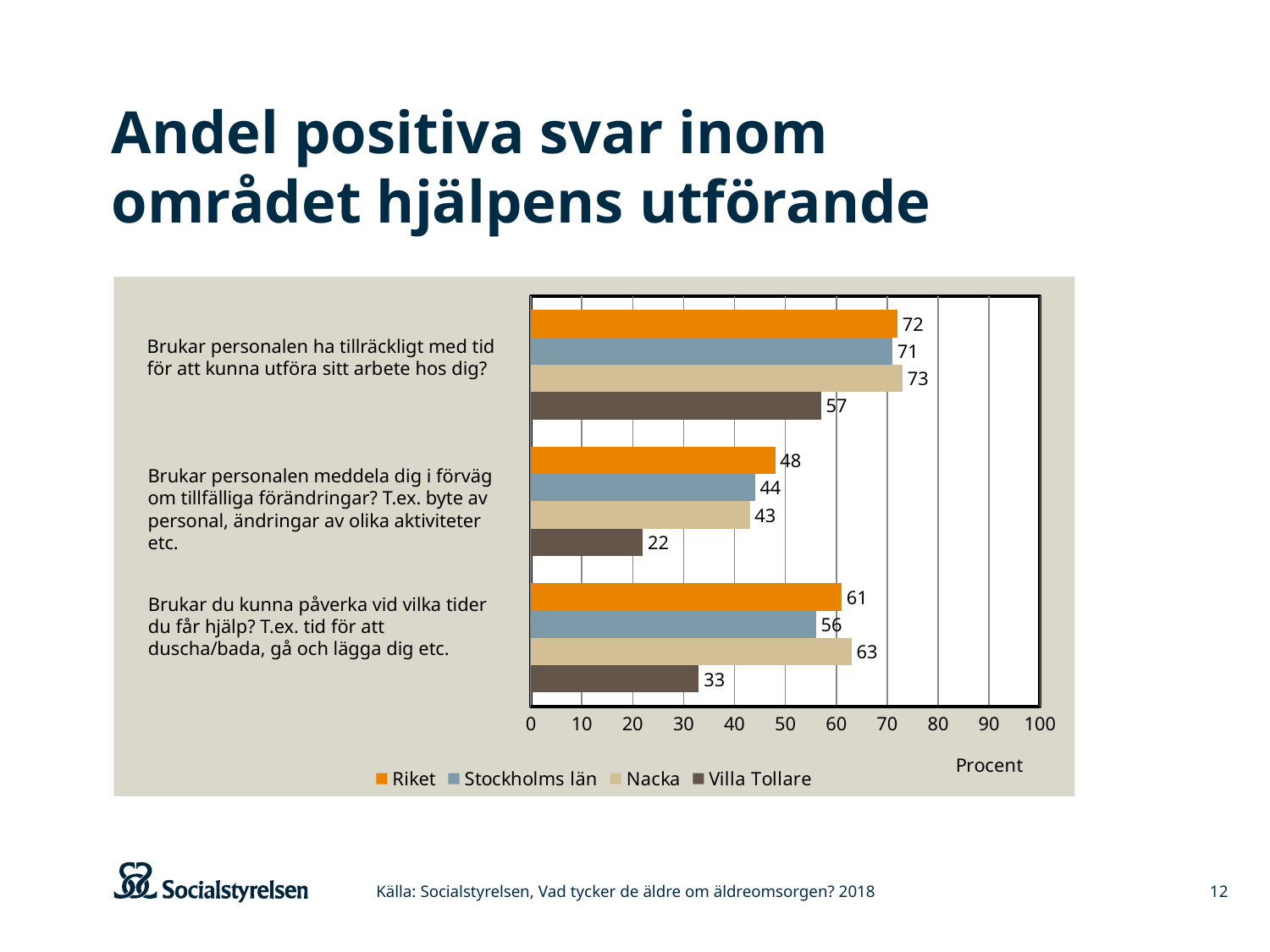
Which is larger on the question 'Brukar personalen meddela dig i förväg om tillfälliga förändringar?': Stockholms län or Nacka? Stockholms län Is the value for Villa Tollare on the question 'Brukar du kunna påverka vid vilka tider du får hjälp?' greater or less than 40? less How many questions (categories) are shown on the chart? 3 What is the value for Nacka on the question 'Brukar du kunna påverka vid vilka tider du får hjälp?' 63 What is the difference between Riket and Villa Tollare on the question 'Brukar du kunna påverka vid vilka tider du får hjälp?' 28 What unit is shown on the x axis of the chart? Procent What is the value for Riket on the question 'Brukar personalen meddela dig i förväg om tillfälliga förändringar?' 48 How many series does the legend list? 4 What kind of chart is shown on the slide? Bar chart Which series has the lowest value on the question 'Brukar personalen meddela dig i förväg om tillfälliga förändringar?' Villa Tollare What is the value for Villa Tollare on the question 'Brukar personalen ha tillräckligt med tid för att kunna utföra sitt arbete hos dig?' 57 Which series has the highest value on the question 'Brukar personalen ha tillräckligt med tid för att kunna utföra sitt arbete hos dig?' Nacka